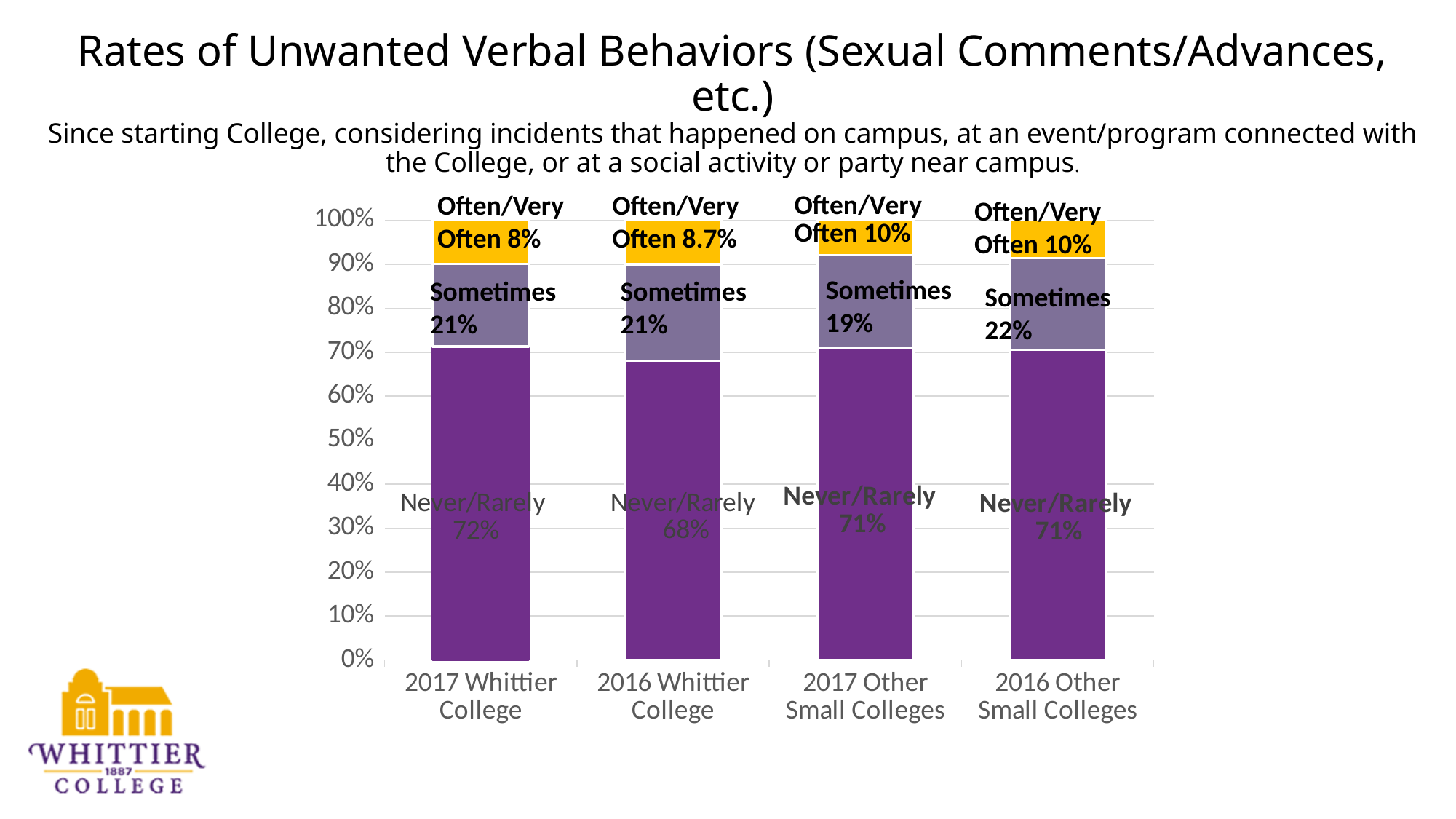
Which category has the lowest Never/Rarely value? 2016 Whittier College What kind of chart is shown on the slide? Stacked bar chart Which category has the highest Sometimes value? 2016 Other Small Colleges Which is larger, the Sometimes value for 2016 Other Small Colleges or for 2017 Other Small Colleges? 2016 Other Small Colleges What is the Often/Very Often value for 2016 Whittier College? 8.7% Is the Never/Rarely value for 2016 Whittier College greater or less than 70%? less Which category has the highest Never/Rarely value? 2017 Whittier College How many categories are shown on the x axis? 4 What is the Sometimes value for 2017 Other Small Colleges? 19% What is the Often/Very Often value for 2016 Other Small Colleges? 10% What is the Never/Rarely value for 2017 Whittier College? 72% What is the difference between the Never/Rarely values for 2017 Whittier College and 2016 Whittier College? 4 percentage points